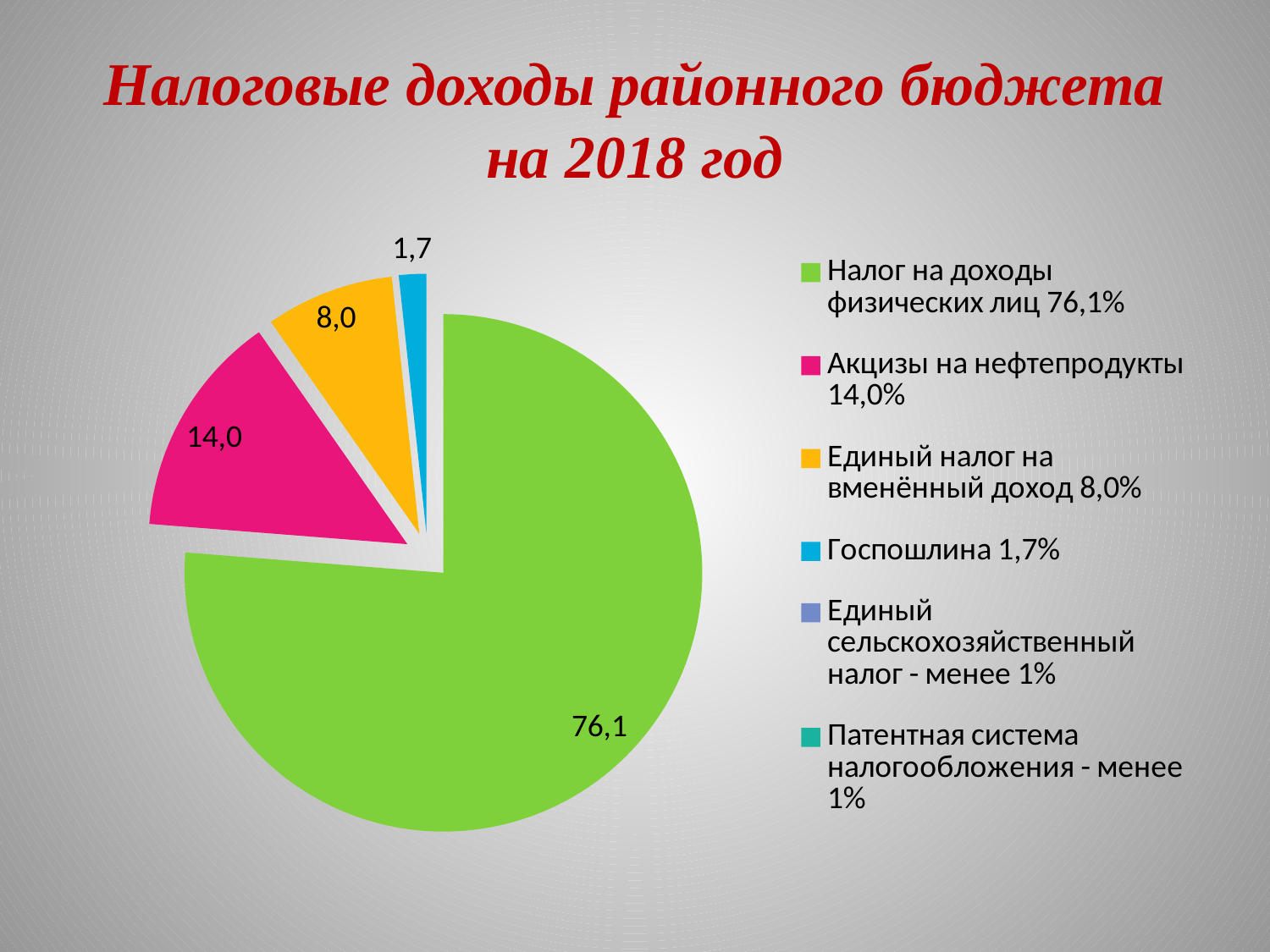
What is the value shown for the slice "Налог на доходы физических лиц"? 76,1 Which is larger: the slice for "Акцизы на нефтепродукты" or the slice for "Единый налог на вменённый доход"? Акцизы на нефтепродукты What is the value shown for the slice "Госпошлина"? 1,7 How many entries does the legend list? 6 What kind of chart is shown on the slide? pie chart What is the value shown for the slice "Акцизы на нефтепродукты"? 14,0 Which of the labelled slices is the smallest? Госпошлина What is the title of the slide? Налоговые доходы районного бюджета на 2018 год What is the difference between the values for "Налог на доходы физических лиц" and "Акцизы на нефтепродукты"? 62,1 What is the value shown for the slice "Единый налог на вменённый доход"? 8,0 What is the difference between the values for "Единый налог на вменённый доход" and "Госпошлина"? 6,3 Which category has the largest slice of the pie? Налог на доходы физических лиц